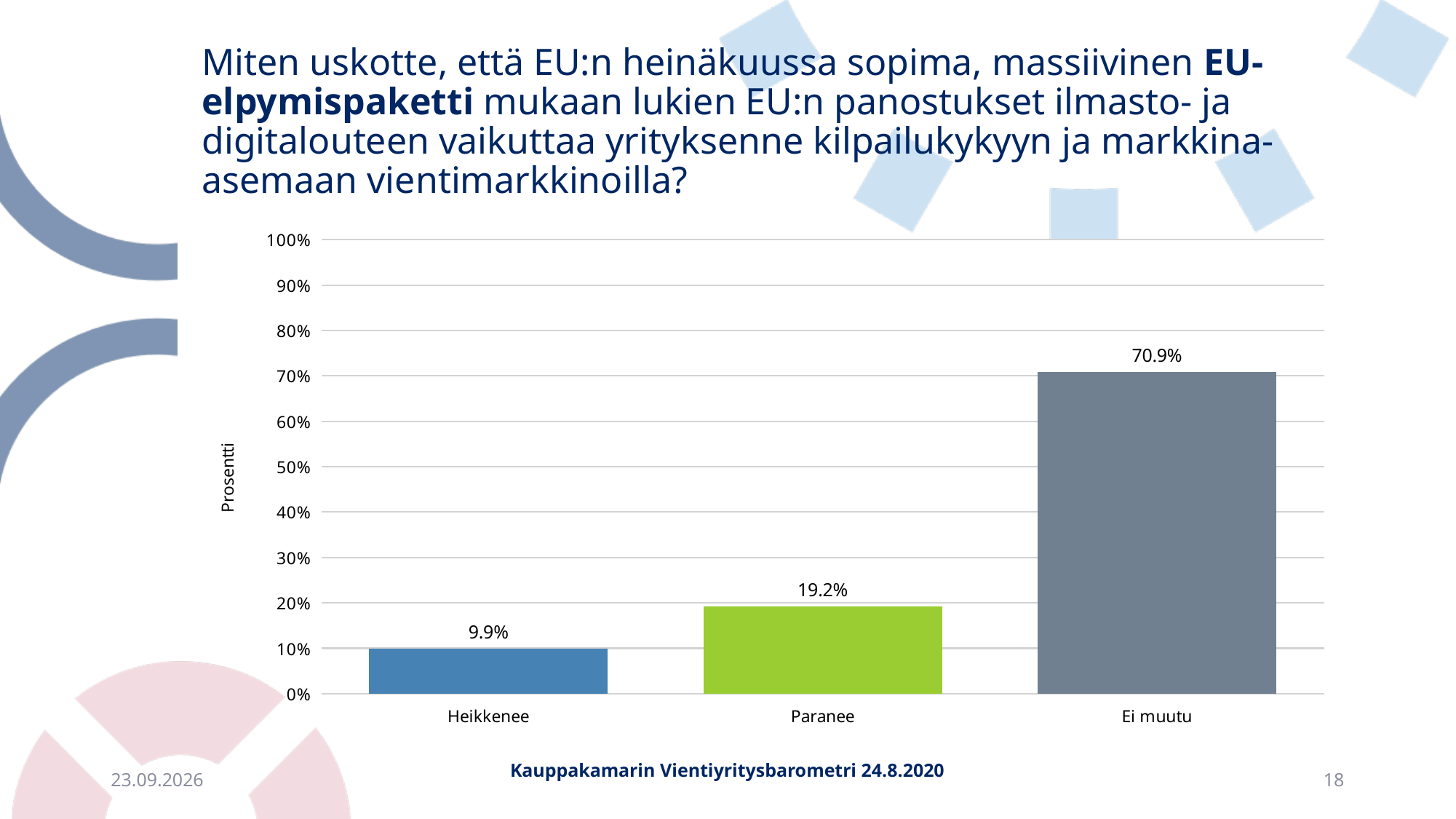
What is the difference between the values for Paranee and Heikkenee? 9.3% Which is larger, the value for Paranee or the value for Heikkenee? Paranee How many categories are shown on the x axis? 3 What is the value for Heikkenee? 9.9% Is the value for Ei muutu greater or less than 60%? greater What is the value for Paranee? 19.2% Which category has the lowest value? Heikkenee What is the value for Ei muutu? 70.9% What is the difference between the values for Ei muutu and Paranee? 51.7% What kind of chart is shown on the slide? bar chart Which category has the highest value? Ei muutu What is the label of the vertical axis? Prosentti